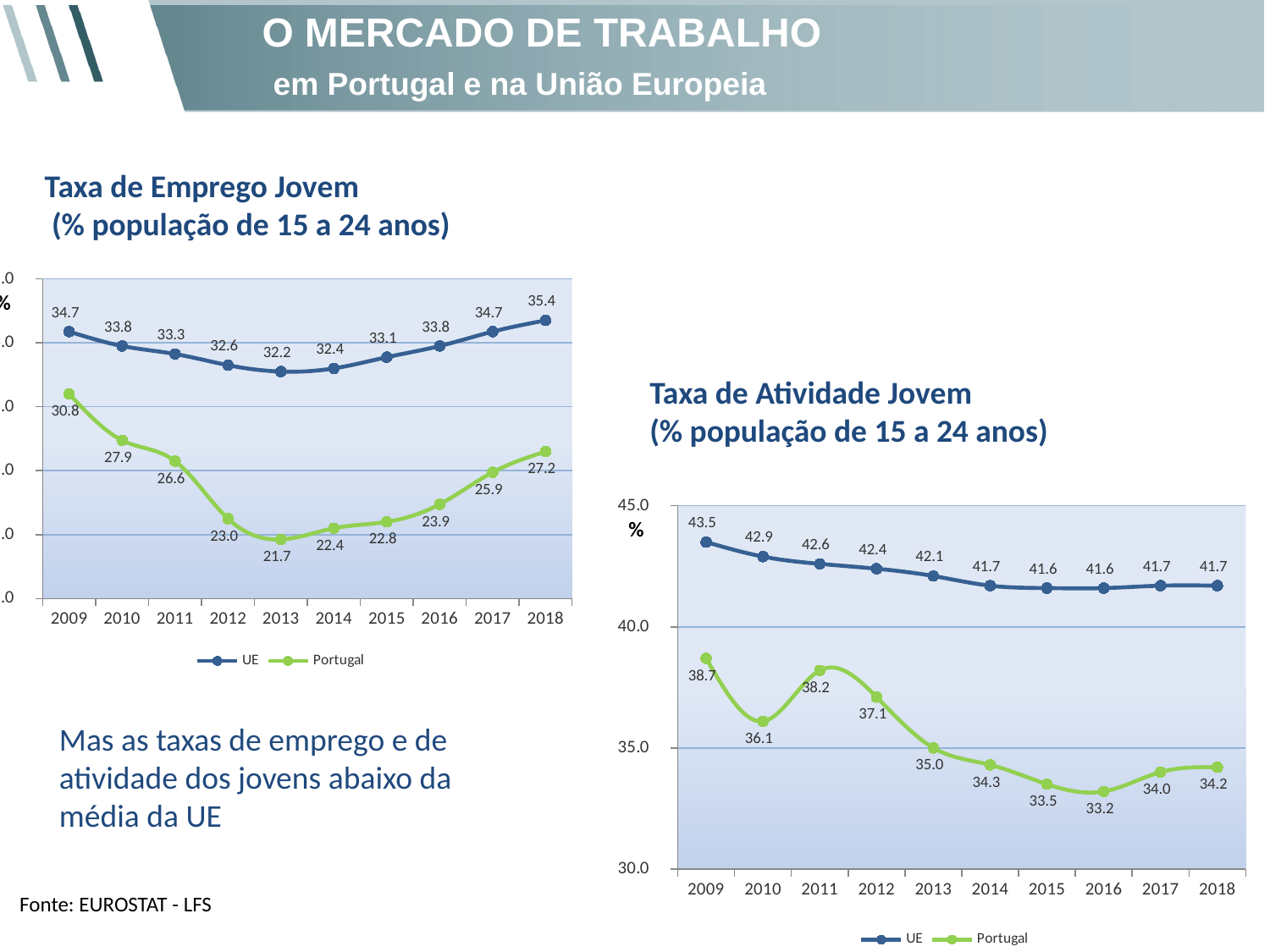
In the 'Taxa de Emprego Jovem' chart, what is the value for UE in 2018? 35.4 In the 'Taxa de Atividade Jovem' chart, is the value for Portugal in 2015 greater or less than 35.0? less In the 'Taxa de Atividade Jovem' chart, which is larger: Portugal in 2011 or Portugal in 2012? Portugal in 2011 In the 'Taxa de Emprego Jovem' chart, how many series does the legend list? 2 In the 'Taxa de Emprego Jovem' chart, which year has the lowest value for Portugal? 2013 What kind of chart is the 'Taxa de Atividade Jovem' chart? Line chart In the 'Taxa de Atividade Jovem' chart, which year has the highest value for UE? 2009 In the 'Taxa de Atividade Jovem' chart, what is the value for Portugal in 2016? 33.2 In the 'Taxa de Atividade Jovem' chart, how many years are shown on the x axis? 10 In the 'Taxa de Emprego Jovem' chart, what is the value for Portugal in 2013? 21.7 In the 'Taxa de Emprego Jovem' chart, what is the difference between UE and Portugal in 2009? 3.9 In the 'Taxa de Atividade Jovem' chart, what is the value for UE in 2009? 43.5